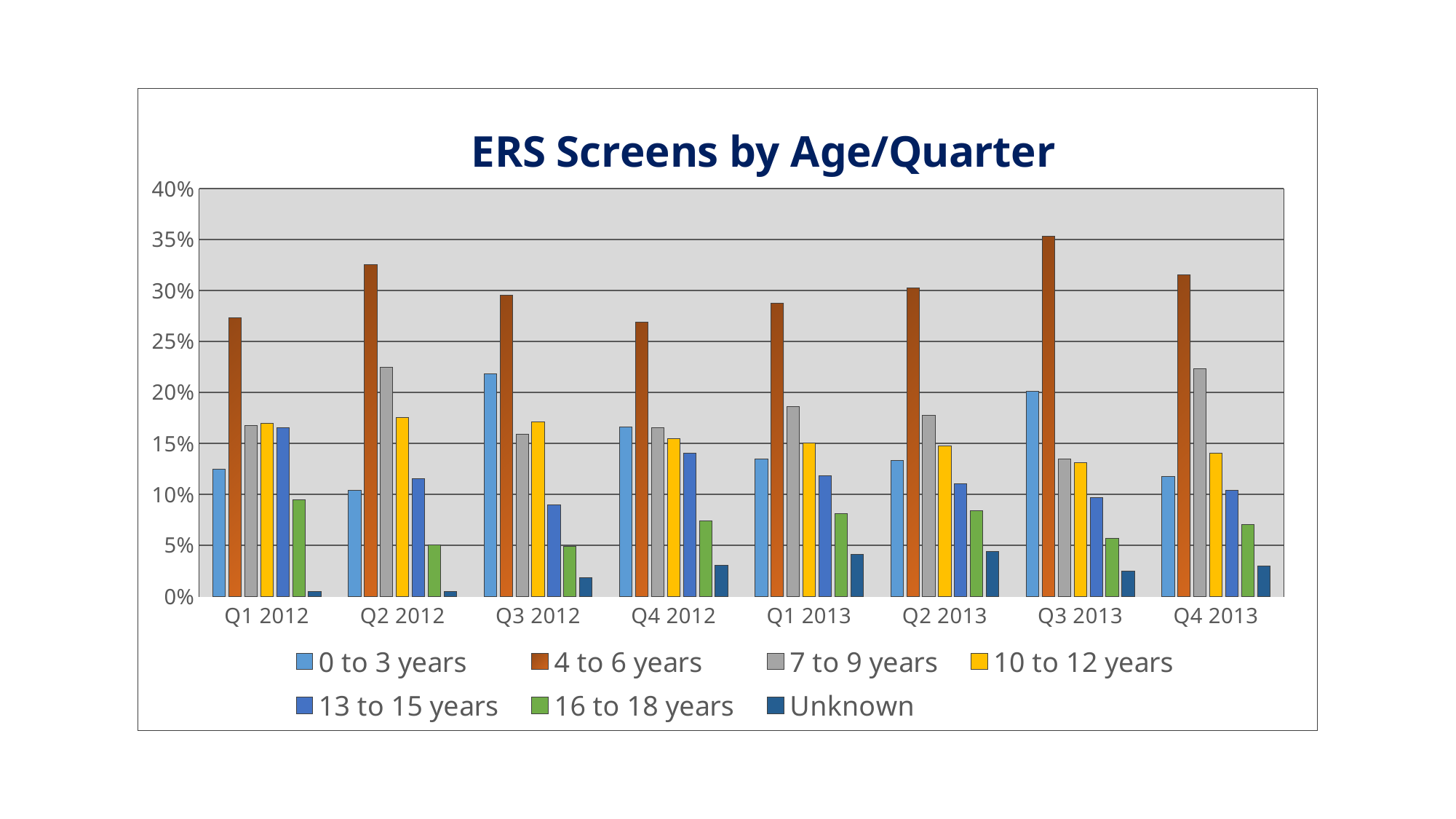
Is the value for 0 to 3 years in Q3 2012 greater or less than 20%? greater Is the value for 4 to 6 years in Q2 2012 greater or less than 30%? greater How many series does the legend list? 7 Which age group has the lowest value in Q1 2013? Unknown How many quarters are shown on the x axis of the chart? 8 In Q3 2013, which is larger: the value for 0 to 3 years or the value for 7 to 9 years? 0 to 3 years What is the title of the chart? ERS Screens by Age/Quarter In Q2 2012, which is larger: the value for 7 to 9 years or the value for 10 to 12 years? 7 to 9 years In which quarter is the value for 4 to 6 years the highest? Q3 2013 Which age group has the highest value in Q4 2013? 4 to 6 years What kind of chart is shown on the slide? Bar chart Is the value for Unknown in Q1 2012 greater or less than 5%? less